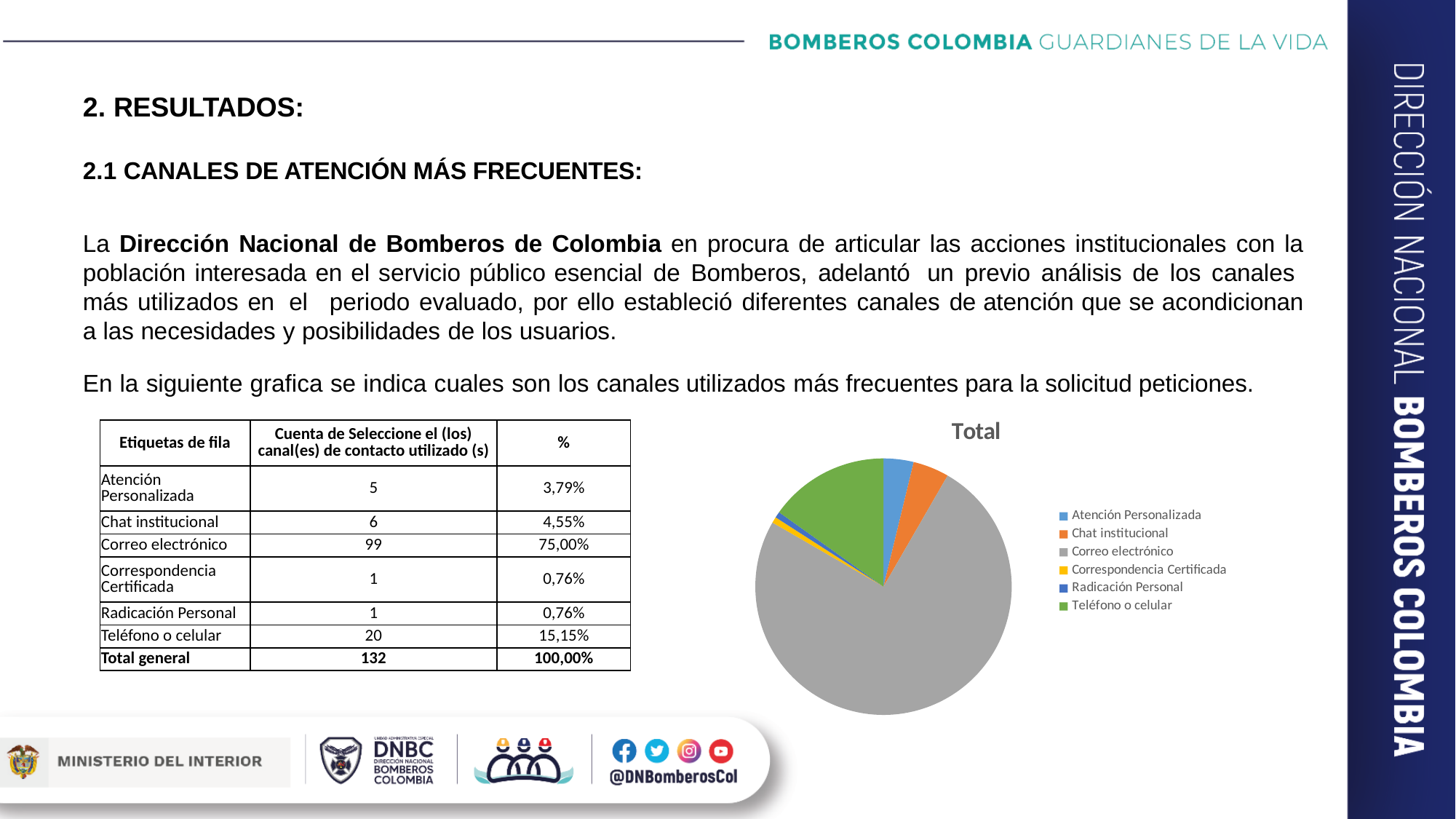
What colour is the Correo electrónico slice in the pie chart? grey What is the title of the pie chart? Total What kind of chart is shown on the slide? pie chart Which slice is larger in the pie chart, Teléfono o celular or Chat institucional? Teléfono o celular Which slice is larger in the pie chart, Correo electrónico or Teléfono o celular? Correo electrónico How many slices does the pie chart have? 6 Which category has the largest slice in the pie chart? Correo electrónico What share of the pie does Correo electrónico represent, according to the table on the slide? 75,00% How many entries does the legend of the pie chart list? 6 What share of the pie does Teléfono o celular represent, according to the table on the slide? 15,15% What is the total count (Total general) shown in the table next to the pie chart? 132 What is the count for Chat institucional shown in the table next to the pie chart? 6